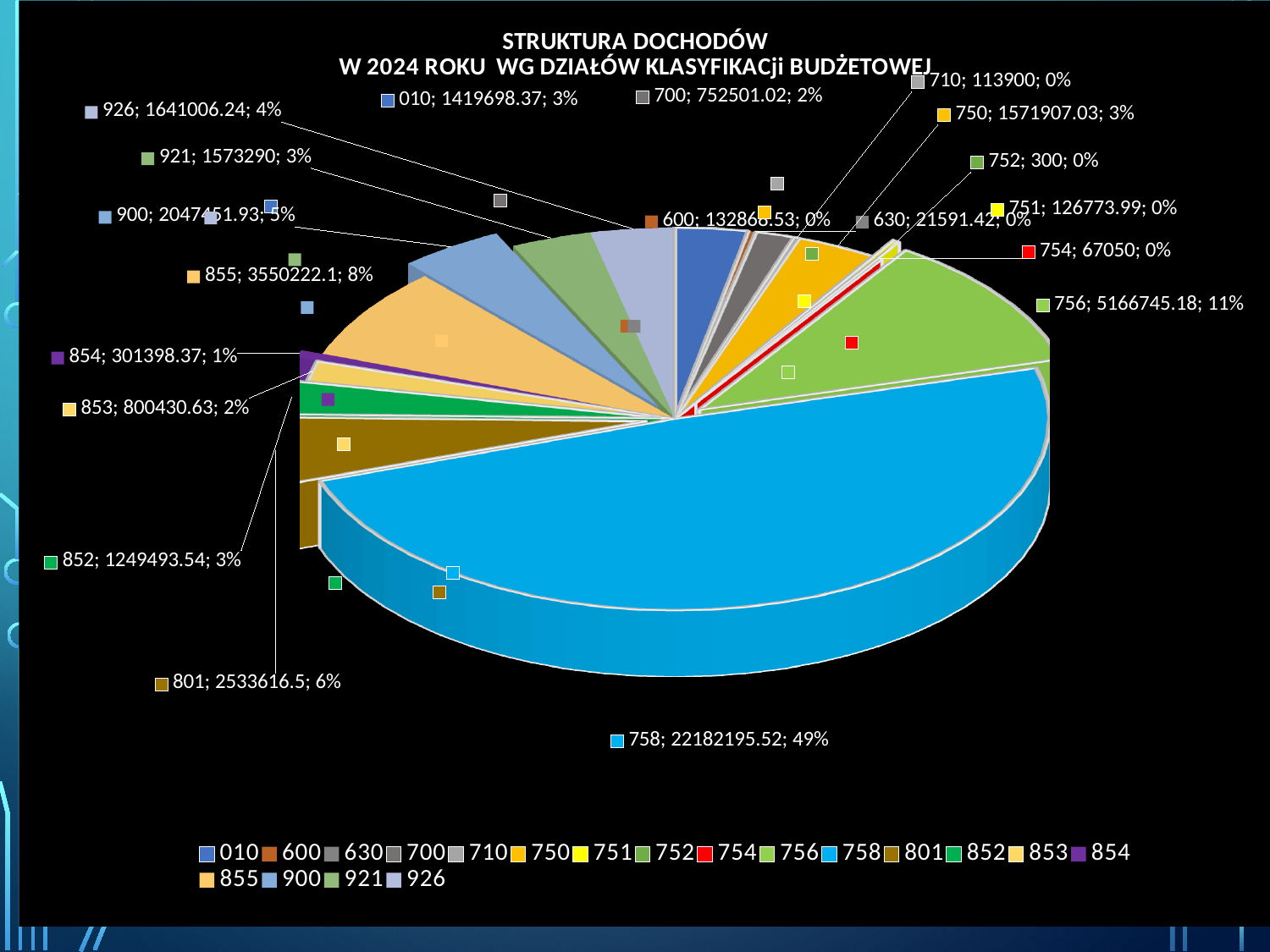
What is the title of the chart? STRUKTURA DOCHODÓW W 2024 ROKU WG DZIAŁÓW KLASYFIKACji BUDŻETOWEJ What is the value shown for category 756? 5166745.18 What percentage is shown for category 801? 6% What kind of chart is shown on the slide? pie chart Which category has the largest slice of the pie? 758 How many categories does the legend list? 19 Which is larger, the value for category 926 or the value for category 010? 926 Which category has the smallest value in the pie? 752 What share of the pie does category 758 represent? 49% What is the value shown for category 855? 3550222.1 What is the difference between the values for category 921 and category 750? 1382.97 What is the value shown for category 752? 300